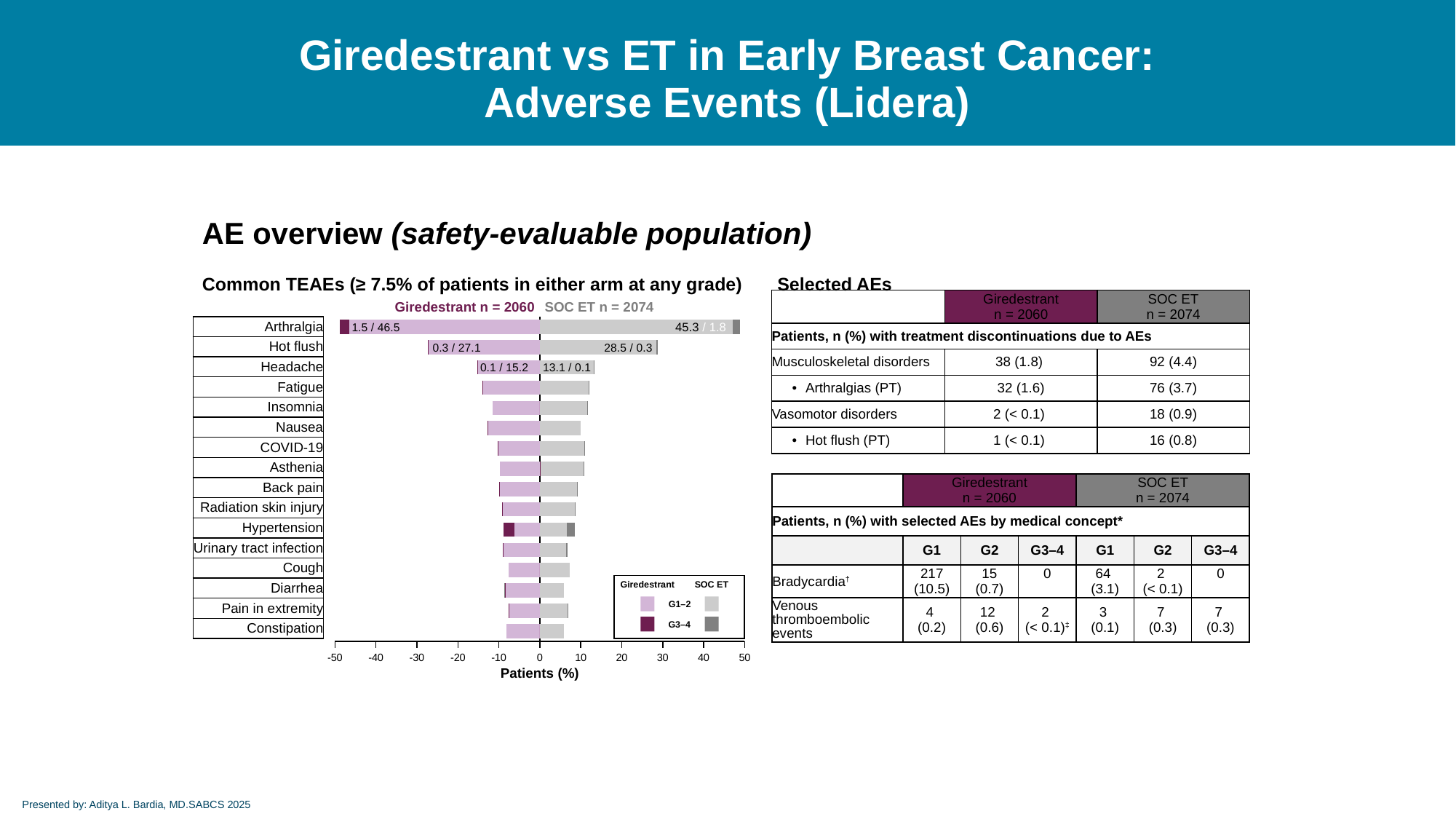
In the Common TEAEs chart, which arm has the higher G1–2 percentage for Hot flush, giredestrant or SOC ET? SOC ET Which adverse event has the longest bars in the Common TEAEs chart? Arthralgia In the Common TEAEs chart, what is the SOC ET G1–2 percentage for Hot flush? 28.5 What kind of chart is used for the Common TEAEs figure? bar chart In the Common TEAEs chart, what is the difference between the giredestrant G1–2 and SOC ET G1–2 percentages for Headache? 2.1 How many entries does the legend of the Common TEAEs chart list? 4 In the Common TEAEs chart, is the giredestrant G1–2 value for Fatigue greater or less than 10%? greater What is the x-axis label of the Common TEAEs chart? Patients (%) In the Common TEAEs chart, what is the giredestrant G3–4 percentage for Headache? 0.1 How many adverse event categories are listed on the y axis of the Common TEAEs chart? 16 In the Common TEAEs chart, what is the giredestrant G1–2 percentage for Arthralgia? 46.5 In the Common TEAEs chart, what is the SOC ET G3–4 percentage for Arthralgia? 1.8